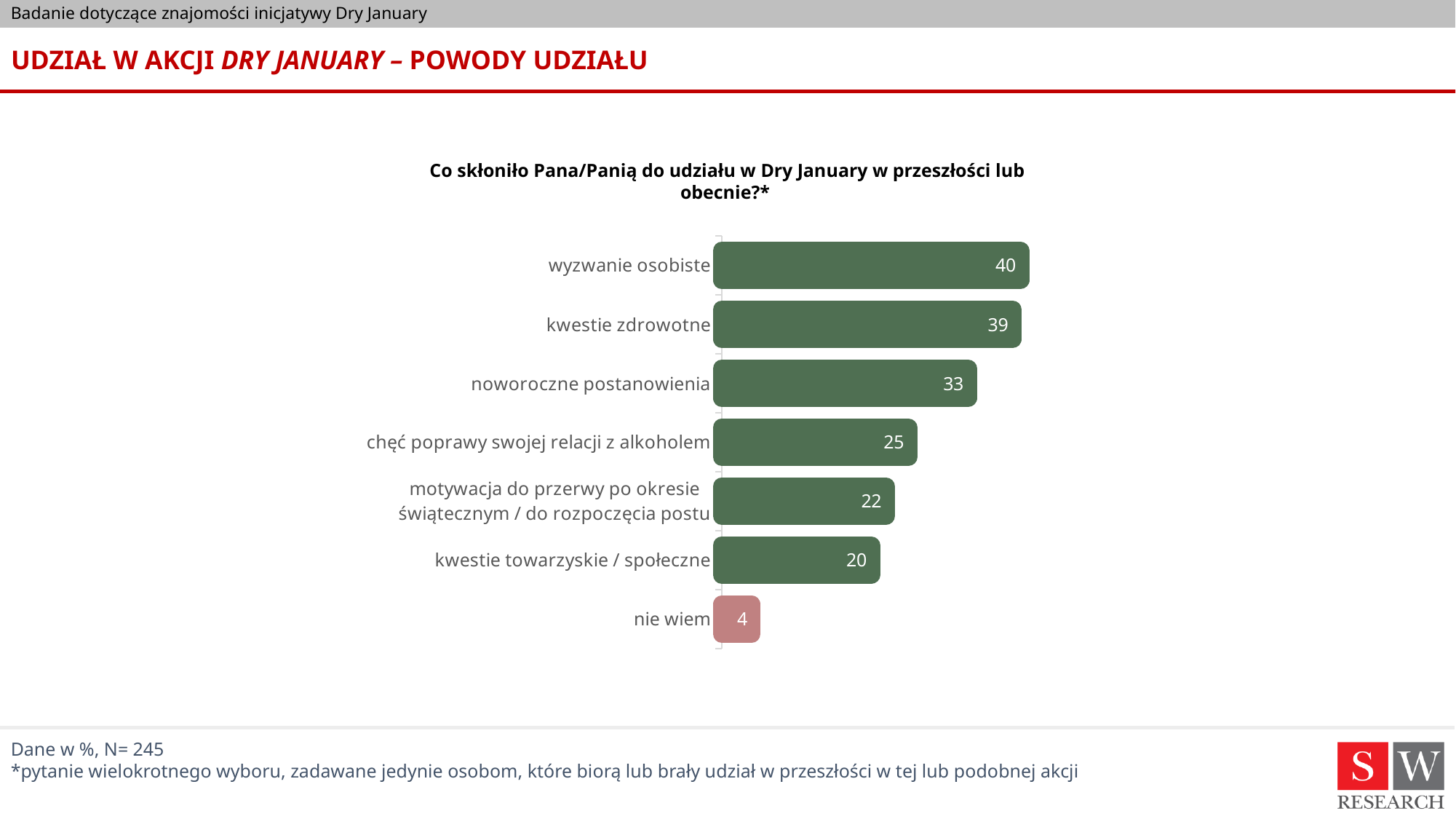
What is the difference between the values for "wyzwanie osobiste" and "nie wiem"? 36 Which category has the lowest value? nie wiem What is the value for "noworoczne postanowienia"? 33 What is the difference between the values for "noworoczne postanowienia" and "chęć poprawy swojej relacji z alkoholem"? 8 What is the value for "kwestie zdrowotne"? 39 What kind of chart is shown on the slide? bar chart Which category has the highest value? wyzwanie osobiste How many categories are shown in the chart? 7 What is the value for "chęć poprawy swojej relacji z alkoholem"? 25 What is the value for "wyzwanie osobiste"? 40 What is the value for "kwestie towarzyskie / społeczne"? 20 Which is larger: the value for "motywacja do przerwy po okresie świątecznym / do rozpoczęcia postu" or the value for "kwestie towarzyskie / społeczne"? motywacja do przerwy po okresie świątecznym / do rozpoczęcia postu